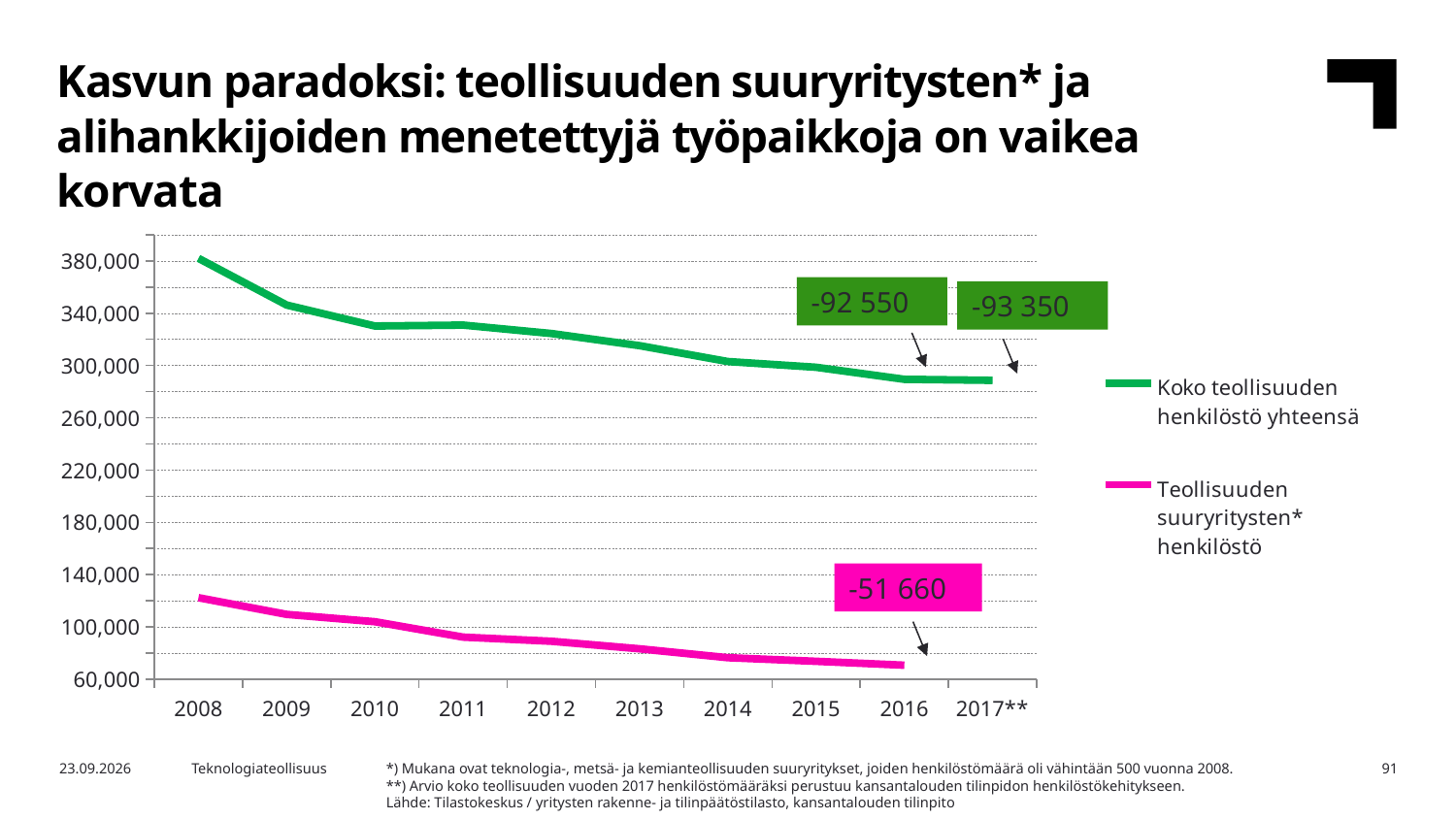
Does the 'Koko teollisuuden henkilöstö yhteensä' series rise or fall from 2008 to 2017**? fall In which year is the 'Koko teollisuuden henkilöstö yhteensä' series highest? 2008 What change is labelled on the green series at 2016? -92 550 In which year is the 'Teollisuuden suuryritysten* henkilöstö' series lowest? 2016 What kind of chart is shown on the slide? line chart What change is labelled on the pink series at 2016? -51 660 In which year is the 'Teollisuuden suuryritysten* henkilöstö' series highest? 2008 Is the value for 'Teollisuuden suuryritysten* henkilöstö' in 2008 greater or less than 100,000? greater How many series does the legend list? 2 How many years are shown on the x axis? 10 Is the value for 'Koko teollisuuden henkilöstö yhteensä' in 2016 greater or less than 300,000? less Is the value for 'Teollisuuden suuryritysten* henkilöstö' in 2016 greater or less than 100,000? less